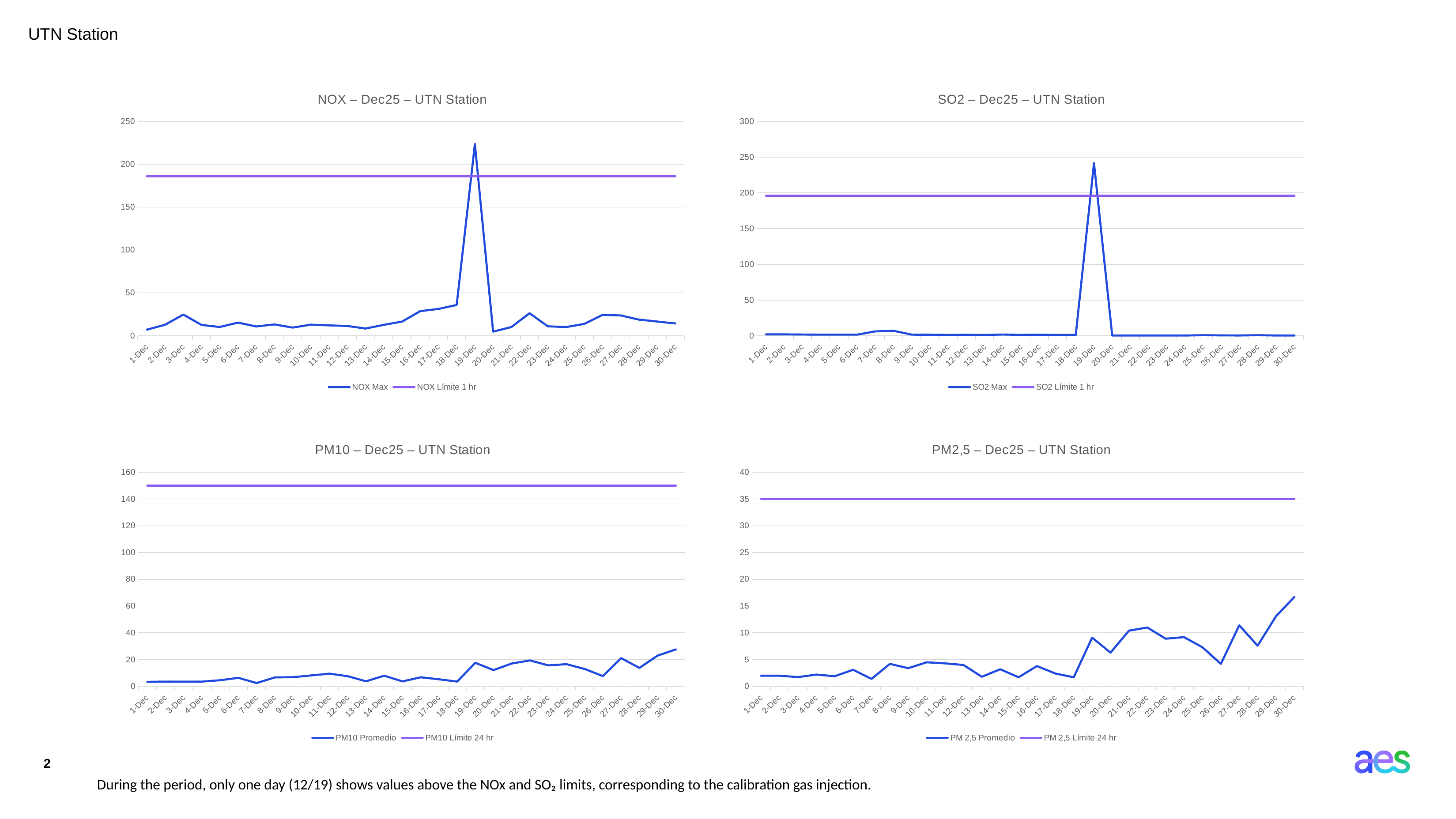
What kind of chart is the PM10 – Dec25 – UTN Station chart? Line chart How many series does the legend of the SO2 – Dec25 – UTN Station chart list? 2 In the PM2,5 – Dec25 – UTN Station chart, is the PM 2,5 Promedio value on 30-Dec greater or less than 15? greater In the PM2,5 – Dec25 – UTN Station chart, on which date is PM 2,5 Promedio highest? 30-Dec In the PM10 – Dec25 – UTN Station chart, is the PM10 Límite 24 hr line greater or less than 140? greater In the SO2 – Dec25 – UTN Station chart, on which date does SO2 Max peak? 19-Dec In the PM10 – Dec25 – UTN Station chart, on which date is PM10 Promedio highest? 30-Dec In the SO2 – Dec25 – UTN Station chart, is the SO2 Max value on 19-Dec greater or less than 200? greater In the PM2,5 – Dec25 – UTN Station chart, what value does the PM 2,5 Límite 24 hr line sit at? 35 How many dates are shown on the x axis of the NOX – Dec25 – UTN Station chart? 30